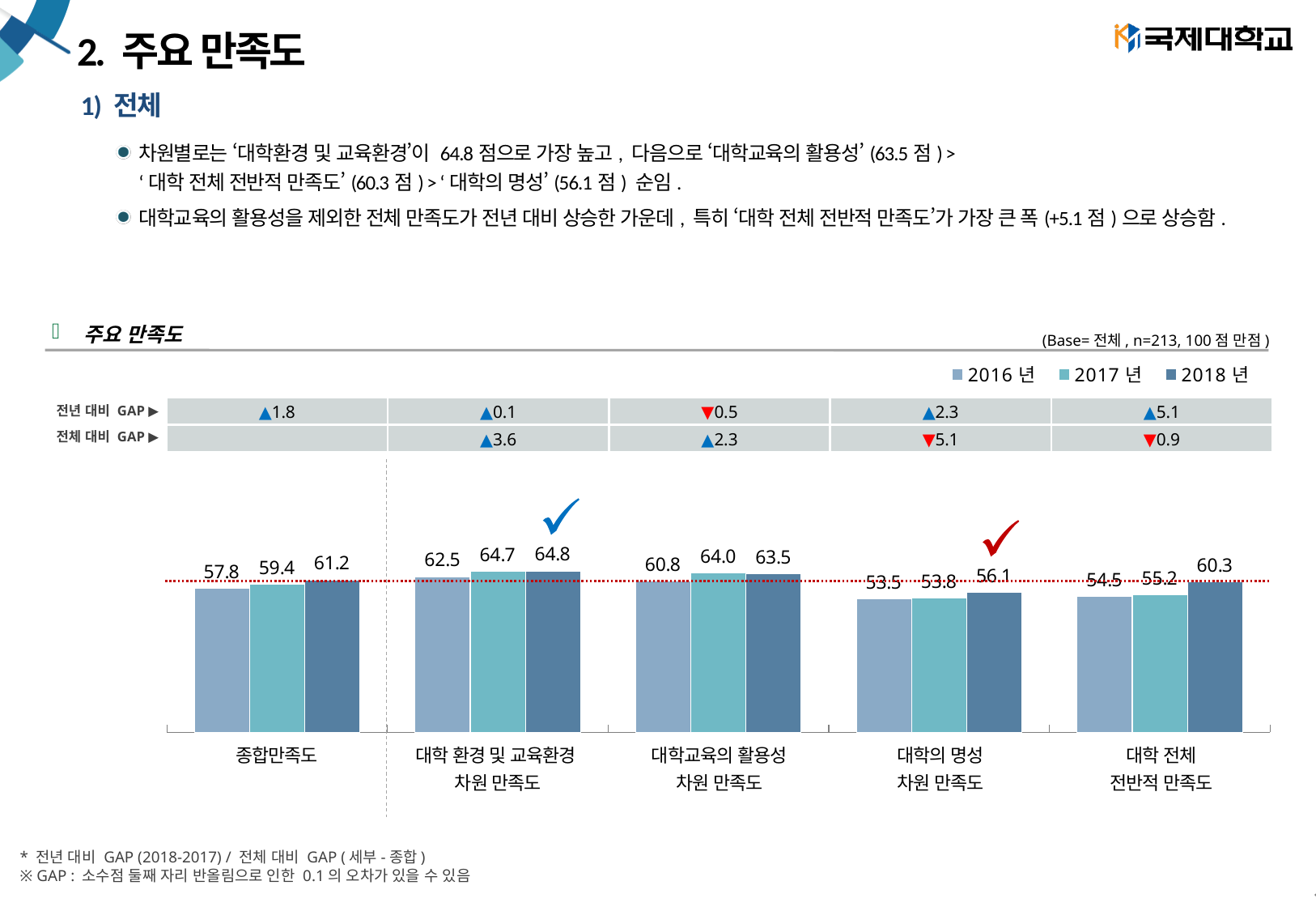
What kind of chart is shown on the slide? bar chart Do the values for 종합만족도 rise or fall from 2016년 to 2018년? rise What is the 2017년 value for 대학교육의 활용성 차원 만족도? 64.0 Which category has the lowest 2016년 value? 대학의 명성 차원 만족도 How many categories are shown on the x axis of the chart? 5 What is the 2016년 value for 대학의 명성 차원 만족도? 53.5 How many series does the legend list? 3 What is the difference between the 2018년 and 2017년 values for 대학 전체 전반적 만족도? 5.1 What is the 2018년 value for 종합만족도? 61.2 Which is larger for 대학교육의 활용성 차원 만족도: the 2017년 value or the 2018년 value? 2017년 Which category has the highest 2018년 value? 대학 환경 및 교육환경 차원 만족도 What is the 전년 대비 GAP shown above 대학 전체 전반적 만족도? ▲5.1